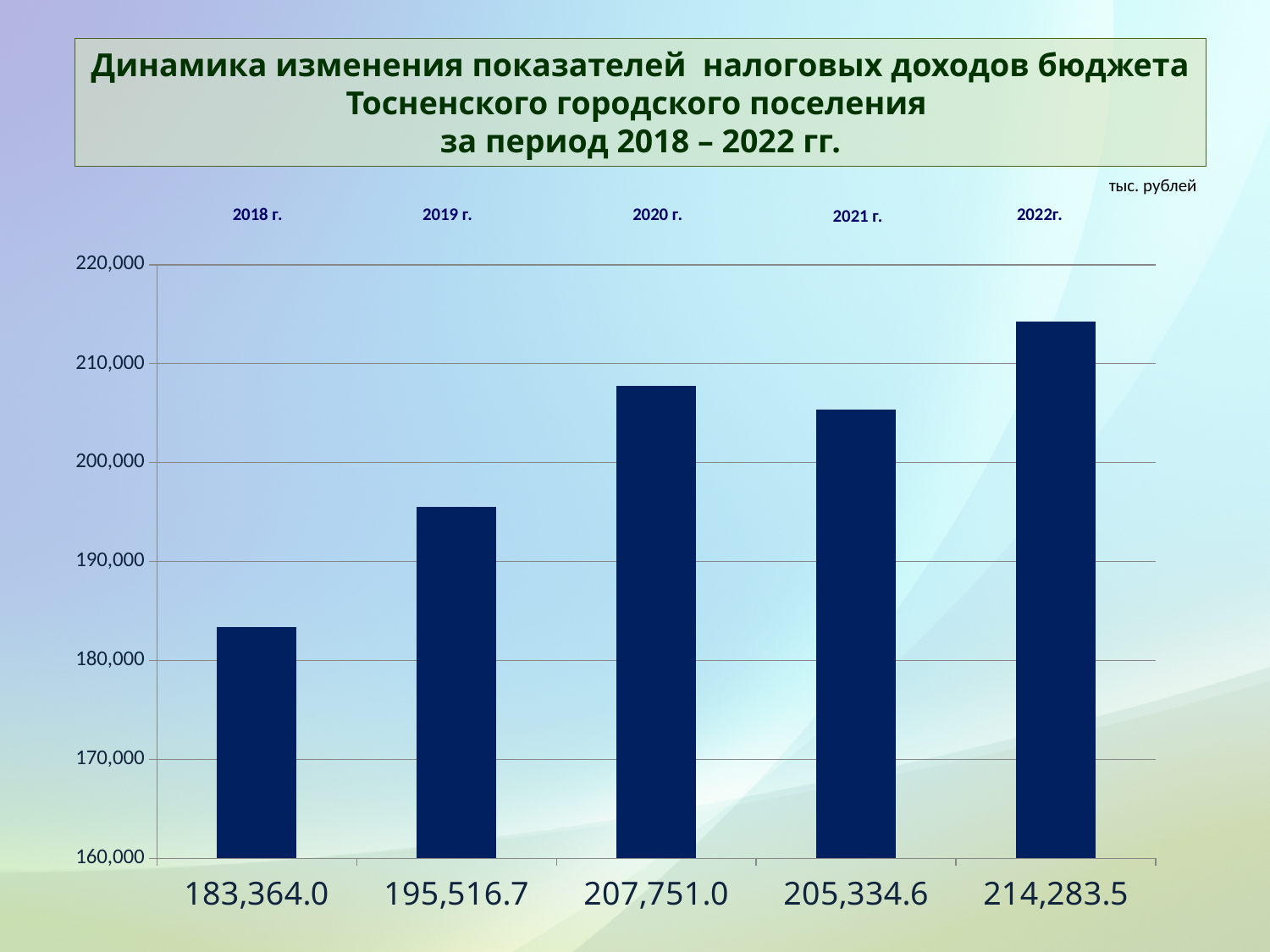
What unit of measurement is indicated for the chart values? тыс. рублей What type of chart is shown on the slide? bar chart How many bars (years) are shown in the chart? 5 What is the difference between the values for 2022г. and 2018 г.? 30,919.5 Which year has the highest tax revenue value? 2022г. Is the value for 2019 г. greater or less than 200,000? less What is the value shown for 2020 г.? 207,751.0 Which year has the lowest tax revenue value? 2018 г. What is the tax revenue value shown for 2018 г.? 183,364.0 Which is larger, the value for 2020 г. or the value for 2021 г.? 2020 г. What is the difference between the values for 2020 г. and 2021 г.? 2,416.4 What is the value shown for 2022г.? 214,283.5